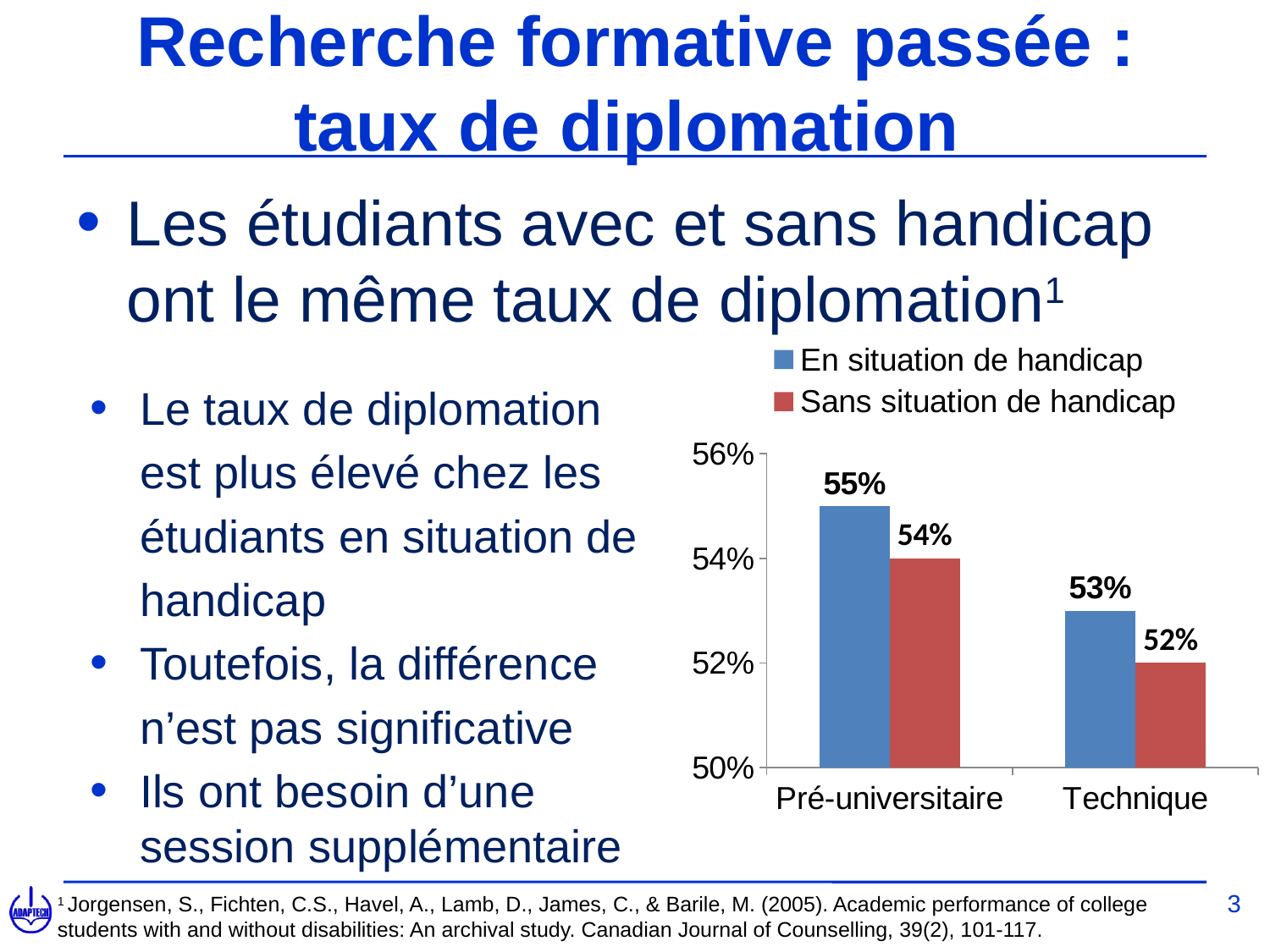
What is the graduation rate for students 'En situation de handicap' in the 'Pré-universitaire' category? 55% Which bar in the chart has the lowest value? Sans situation de handicap, Technique What is the value for 'Sans situation de handicap' in the 'Pré-universitaire' category? 54% What is the value for 'En situation de handicap' in the 'Technique' category? 53% What is the graduation rate for students 'Sans situation de handicap' in the 'Technique' category? 52% What is the difference between the 'En situation de handicap' and 'Sans situation de handicap' values in the 'Pré-universitaire' category? 1% What kind of chart is shown on the slide? Bar chart Which category has the highest value for the 'En situation de handicap' series? Pré-universitaire How many categories are shown on the x axis of the chart? 2 In the 'Technique' category, which series has the larger value? En situation de handicap Which colour represents the 'Sans situation de handicap' series in the chart? Red How many series does the chart legend list? 2